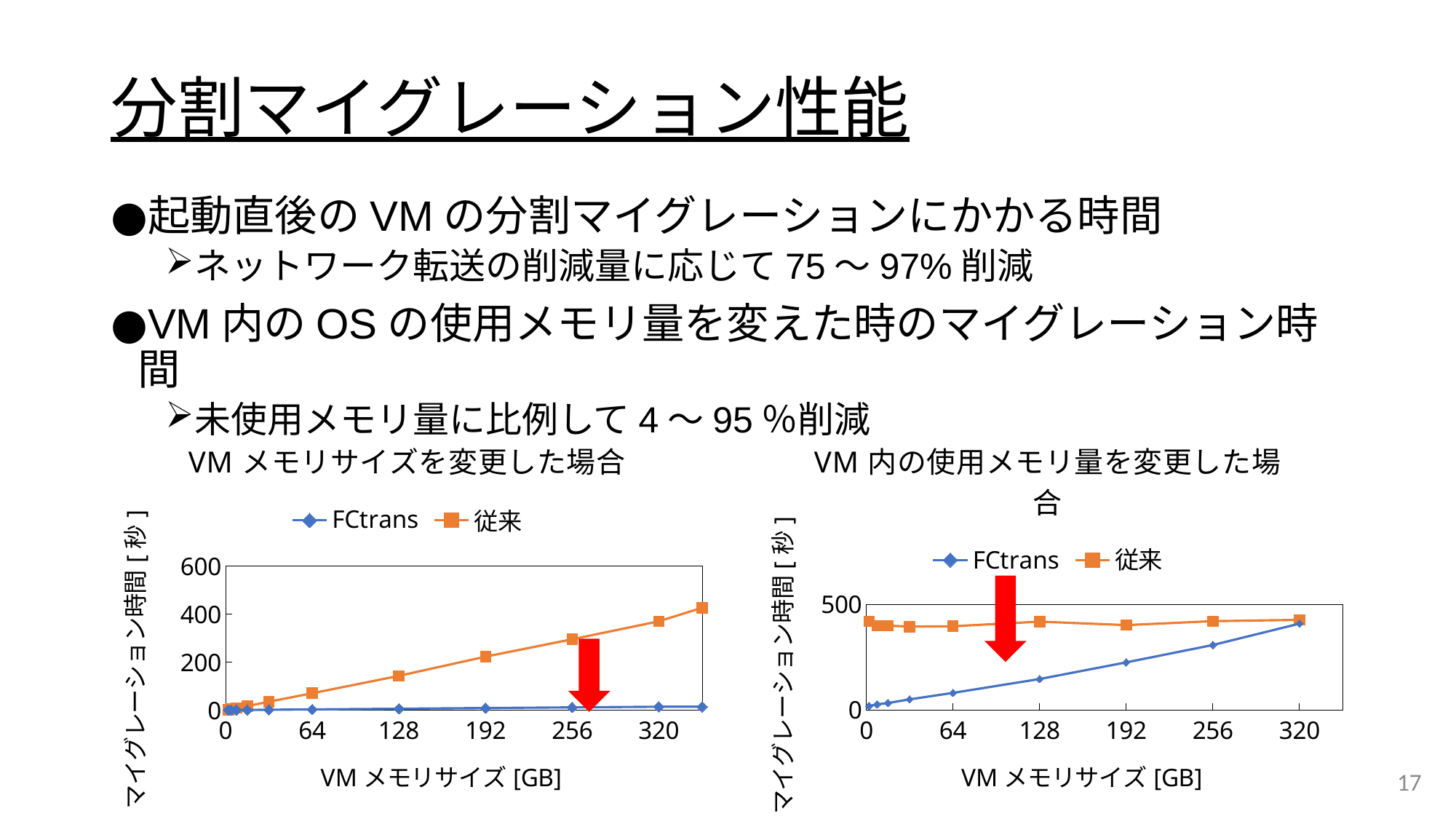
In the right chart 'VM 内の使用メモリ量を変更した場合', does the FCtrans series rise or fall as VM メモリサイズ increases? rise In the left chart 'VM メモリサイズを変更した場合', does the 従来 series rise or fall as VM メモリサイズ increases? rise In the left chart 'VM メモリサイズを変更した場合', which series is plotted in orange? 従来 In the right chart 'VM 内の使用メモリ量を変更した場合', which series has the larger value at 128 GB, FCtrans or 従来? 従来 In the right chart 'VM 内の使用メモリ量を変更した場合', is the 従来 value at 64 GB greater or less than 500? less How many series does the legend of the right chart 'VM 内の使用メモリ量を変更した場合' list? 2 How many series does the legend of the left chart 'VM メモリサイズを変更した場合' list? 2 In the left chart 'VM メモリサイズを変更した場合', is the FCtrans value at 320 GB greater or less than 200? less In the left chart 'VM メモリサイズを変更した場合', which series has the larger value at 256 GB, FCtrans or 従来? 従来 In the left chart 'VM メモリサイズを変更した場合', is the 従来 value at 320 GB greater or less than 200? greater What kind of chart is the left chart titled 'VM メモリサイズを変更した場合'? line chart What is the x-axis label of the right chart 'VM 内の使用メモリ量を変更した場合'? VM メモリサイズ [GB]